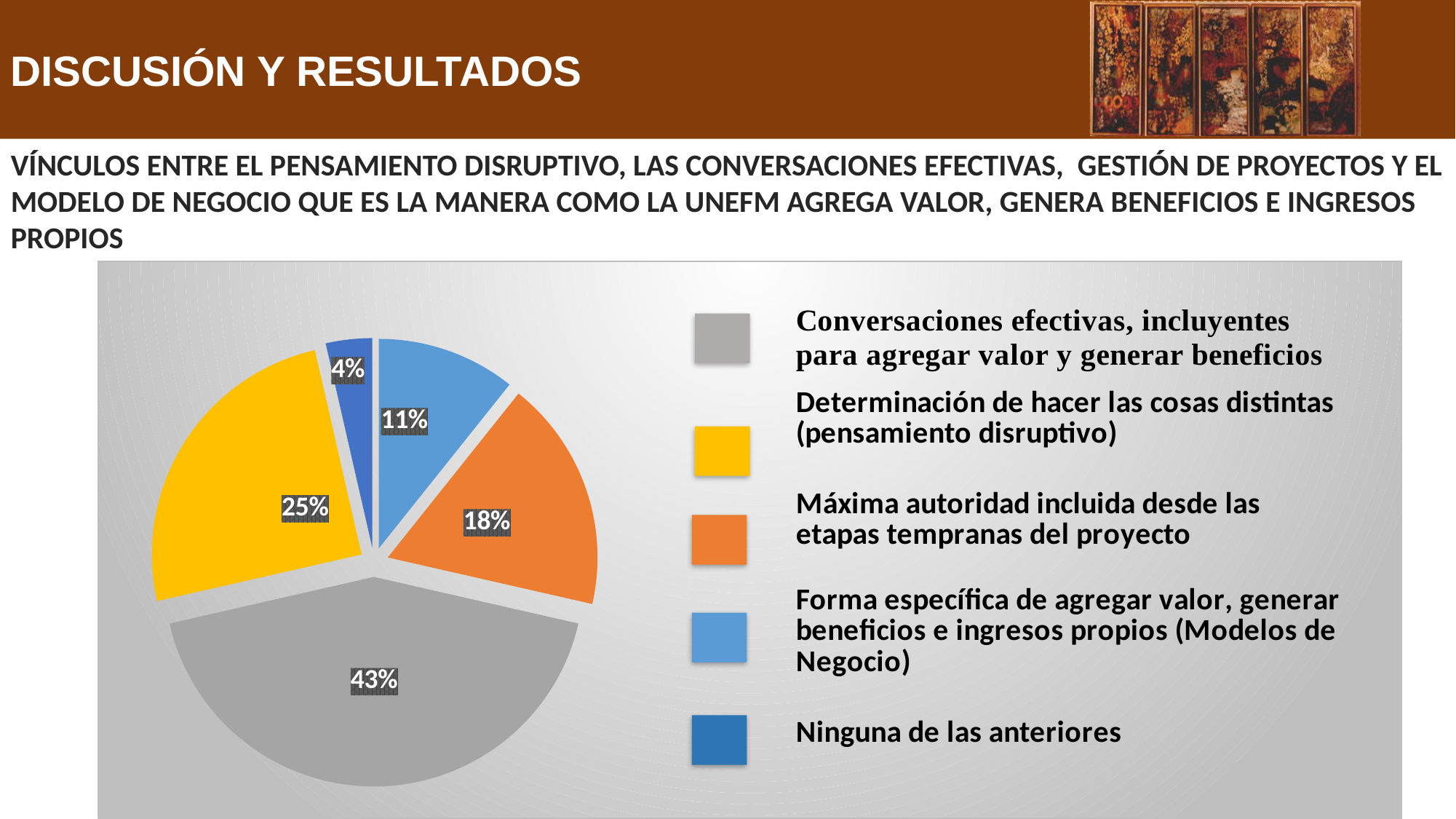
What percentage is shown for 'Determinación de hacer las cosas distintas (pensamiento disruptivo)'? 25% What percentage is shown for 'Máxima autoridad incluida desde las etapas tempranas del proyecto'? 18% What is the difference in percentage points between the 'Conversaciones efectivas' slice and the 'Determinación de hacer las cosas distintas' slice? 18 What colour is the slice for 'Ninguna de las anteriores'? Dark blue What kind of chart is shown on the slide? Pie chart What is the combined percentage of the 'Forma específica de agregar valor (Modelos de Negocio)' and 'Ninguna de las anteriores' slices? 15% Which category has the smallest share of the pie? Ninguna de las anteriores Which is larger: the share for 'Máxima autoridad incluida desde las etapas tempranas del proyecto' or the share for 'Forma específica de agregar valor, generar beneficios e ingresos propios (Modelos de Negocio)'? Máxima autoridad incluida desde las etapas tempranas del proyecto What percentage is shown for 'Conversaciones efectivas, incluyentes para agregar valor y generar beneficios'? 43% Which category has the largest share of the pie? Conversaciones efectivas, incluyentes para agregar valor y generar beneficios What percentage is shown for 'Ninguna de las anteriores'? 4% How many slices does the pie chart have? 5